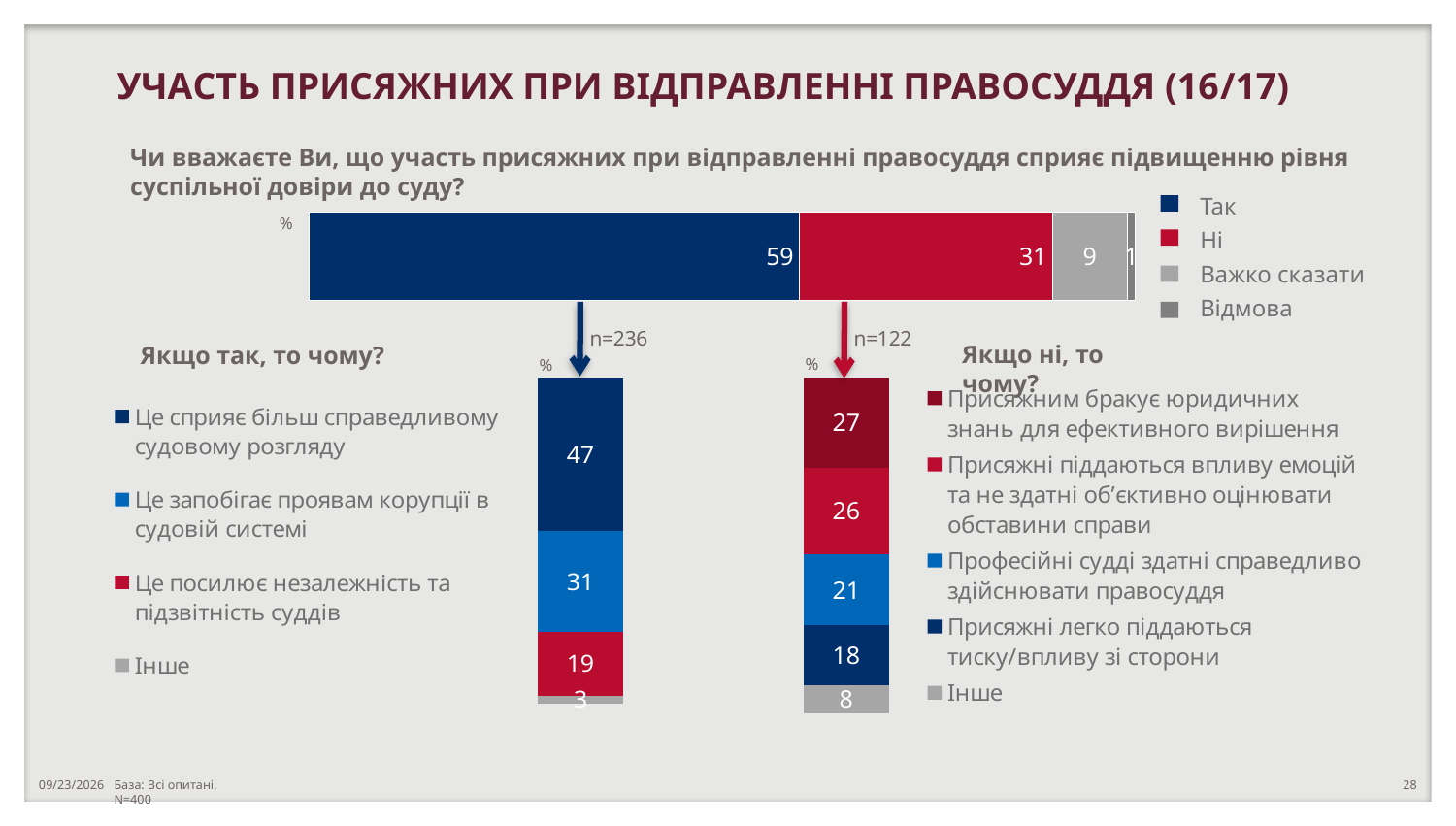
In the "Якщо так, то чому?" chart, what is the value for "Це сприяє більш справедливому судовому розгляду"? 47 In the "Якщо ні, то чому?" chart, what is the value for "Професійні судді здатні справедливо здійснювати правосуддя"? 21 In the top horizontal stacked bar, what percentage of respondents answered "Так"? 59 How many entries does the legend of the top horizontal stacked bar list? 4 In the "Якщо так, то чому?" chart, what is the value for "Це посилює незалежність та підзвітність суддів"? 19 In the "Якщо так, то чому?" chart, which reason has the highest value? Це сприяє більш справедливому судовому розгляду In the top horizontal stacked bar, what percentage of respondents answered "Ні"? 31 What type of chart is the "Якщо ні, то чому?" chart? Stacked bar chart In the "Якщо ні, то чому?" chart, what is the value for "Інше"? 8 In the top horizontal stacked bar, what is the difference between the "Так" and "Ні" values? 28 In the "Якщо ні, то чому?" chart, which is larger: "Присяжні легко піддаються тиску/впливу зі сторони" or "Присяжні піддаються впливу емоцій та не здатні об'єктивно оцінювати обставини справи"? Присяжні піддаються впливу емоцій та не здатні об'єктивно оцінювати обставини справи In the top horizontal stacked bar, what is the value for "Важко сказати"? 9